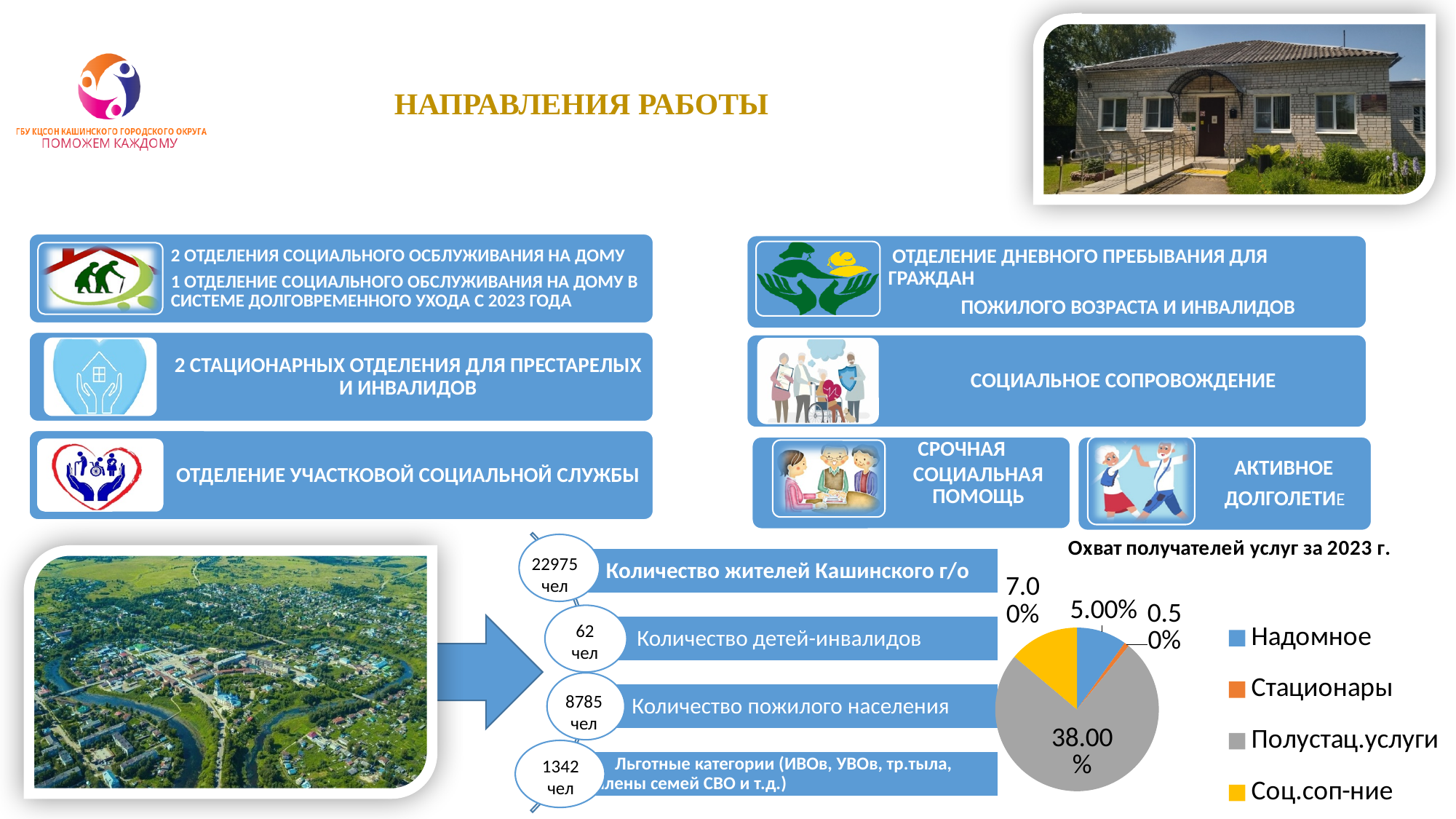
In the pie chart "Охват получателей услуг за 2023 г.", what is the value for Надомное? 5.00% In the pie chart "Охват получателей услуг за 2023 г.", which category has the smallest slice? Стационары In the pie chart "Охват получателей услуг за 2023 г.", what colour is the Соц.соп-ние slice? yellow In the pie chart "Охват получателей услуг за 2023 г.", what is the value for Полустац.услуги? 38.00% In the pie chart "Охват получателей услуг за 2023 г.", what is the value for Стационары? 0.50% In the pie chart "Охват получателей услуг за 2023 г.", what is the value for Соц.соп-ние? 7.00% In the pie chart "Охват получателей услуг за 2023 г.", what is the difference between Полустац.услуги and Соц.соп-ние? 31.00% What kind of chart is shown under the title "Охват получателей услуг за 2023 г."? pie chart In the pie chart "Охват получателей услуг за 2023 г.", which is larger: Надомное or Соц.соп-ние? Соц.соп-ние In the pie chart "Охват получателей услуг за 2023 г.", what is the difference between Надомное and Стационары? 4.50% In the pie chart "Охват получателей услуг за 2023 г.", which category has the largest slice? Полустац.услуги How many categories does the legend of the pie chart "Охват получателей услуг за 2023 г." list? 4